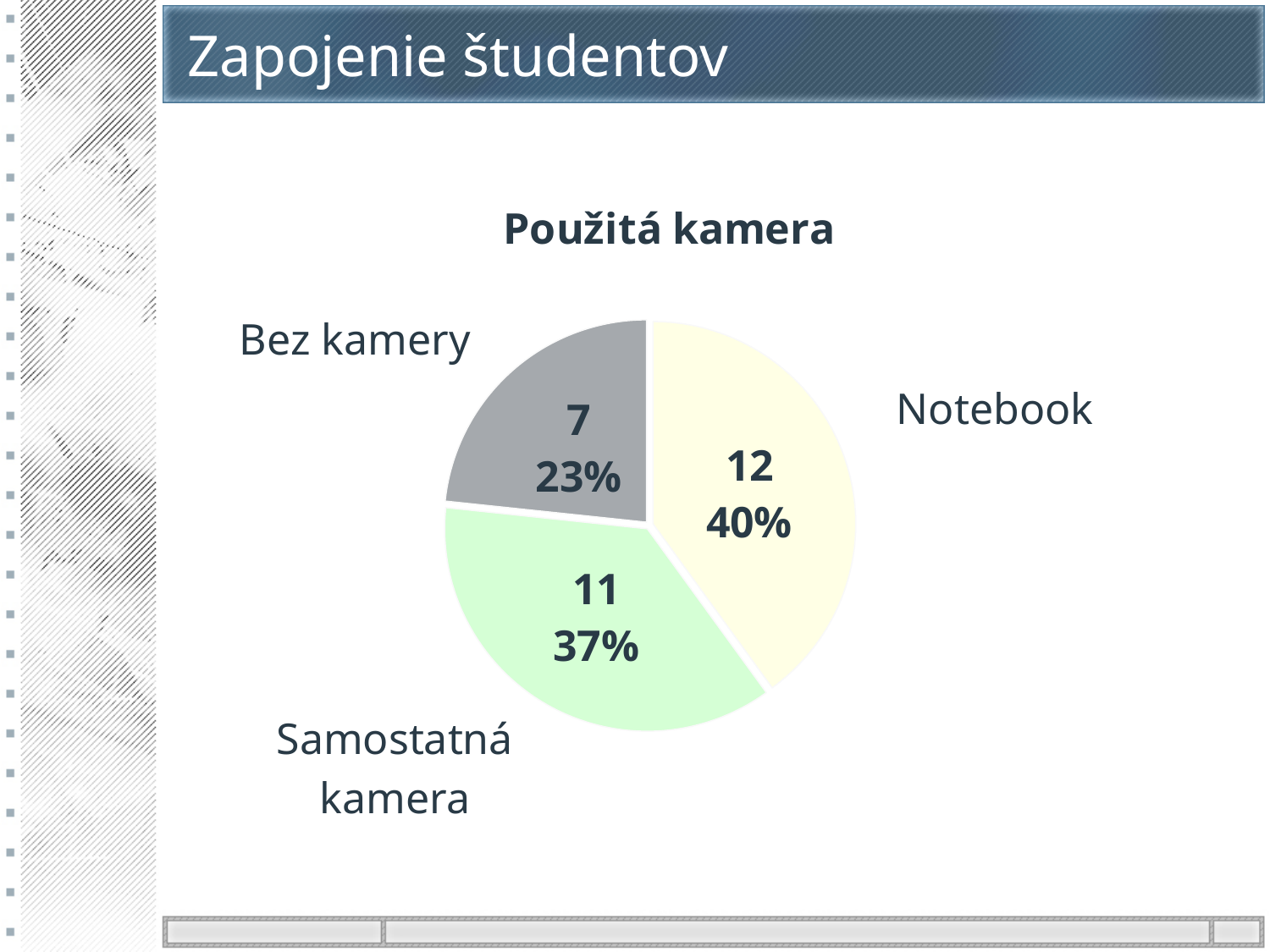
Which category has the smallest slice? Bez kamery How many slices does the pie chart have? 3 What is the value for Samostatná kamera? 11 What share of the pie does Samostatná kamera represent? 37% What is the difference between the values for Notebook and Bez kamery? 5 What is the title of the chart? Použitá kamera What kind of chart is shown on the slide? pie chart What share of the pie does Bez kamery represent? 23% What is the value for Notebook? 12 What share of the pie does Notebook represent? 40% Which category has the largest slice? Notebook What is the value for Bez kamery? 7